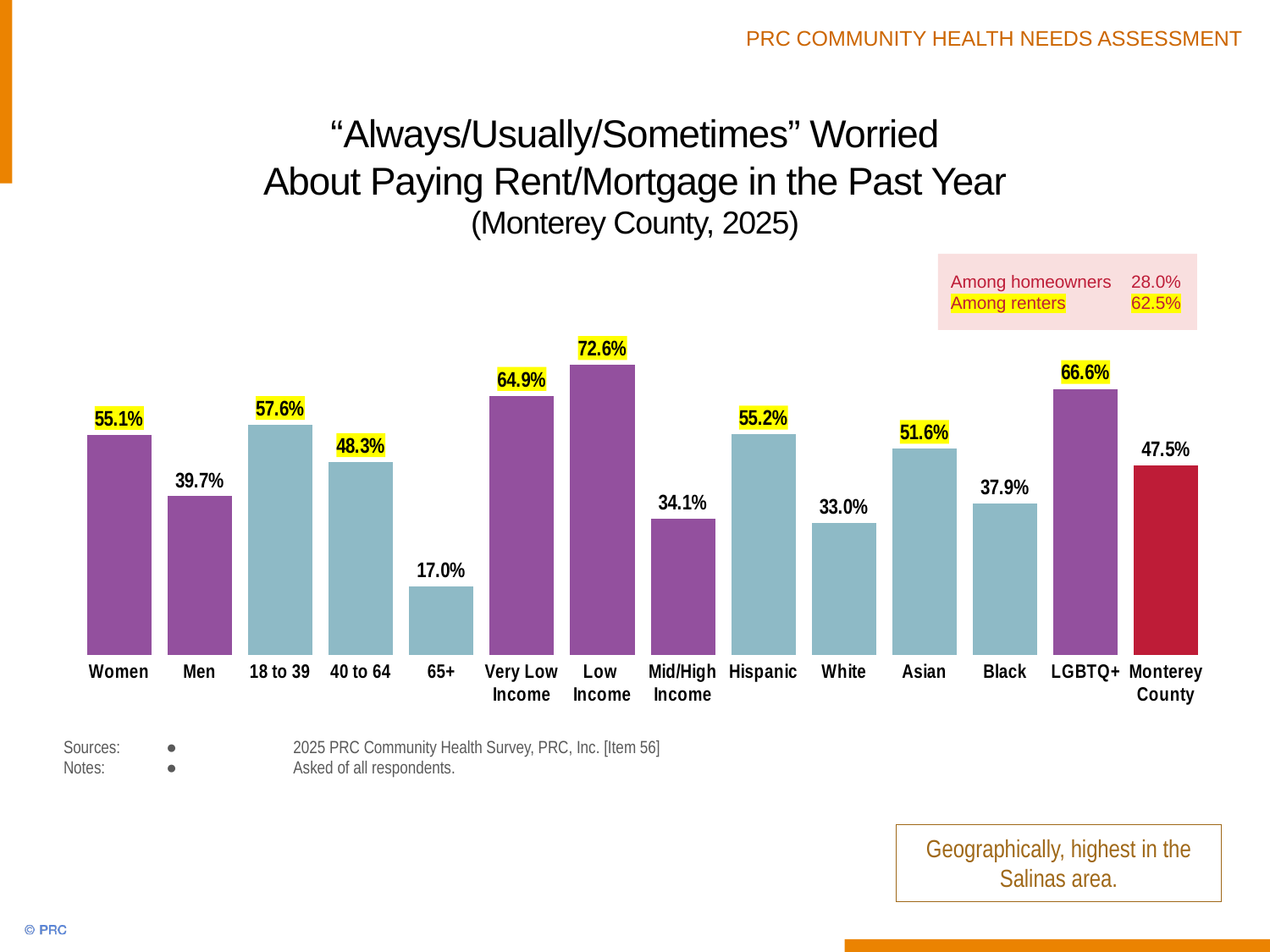
Which is larger, the value for Hispanic or the value for White? Hispanic What is the difference between the values for Women and Men? 15.4% What is the value for Women? 55.1% What is the value for Monterey County overall? 47.5% According to the box on the slide, what is the value among renters? 62.5% Which category has the highest value? Low Income What is the value for the 65+ age group? 17.0% What is the difference between the values for Very Low Income and Mid/High Income? 30.8% Which category has the lowest value? 65+ Which is larger, the value for LGBTQ+ or the value for Asian? LGBTQ+ How many bars are shown in the chart? 14 What kind of chart is shown on the slide? Bar chart